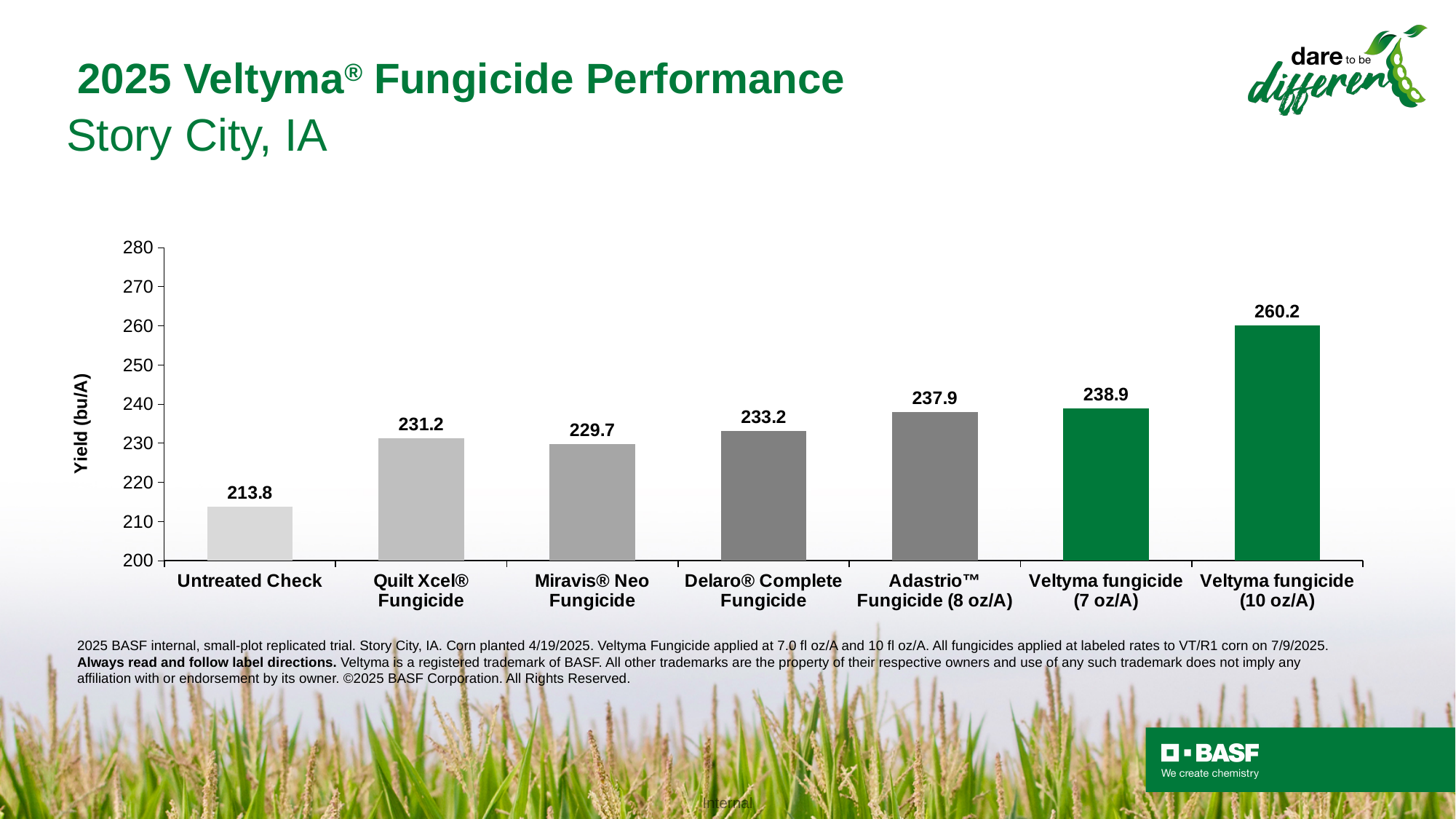
What is the yield for Untreated Check? 213.8 What is the difference in yield between Veltyma fungicide (10 oz/A) and Untreated Check? 46.4 Is the yield for Quilt Xcel Fungicide greater or less than 240? less What is the difference in yield between Veltyma fungicide (7 oz/A) and Quilt Xcel Fungicide? 7.7 What is the yield for Adastrio Fungicide (8 oz/A)? 237.9 How many treatments are shown in the chart? 7 What is the label of the y axis? Yield (bu/A) What is the yield for Veltyma fungicide (10 oz/A)? 260.2 Which treatment has the lowest yield? Untreated Check Which treatment has the highest yield? Veltyma fungicide (10 oz/A) Which has a higher yield, Delaro Complete Fungicide or Miravis Neo Fungicide? Delaro Complete Fungicide What kind of chart is shown on the slide? bar chart